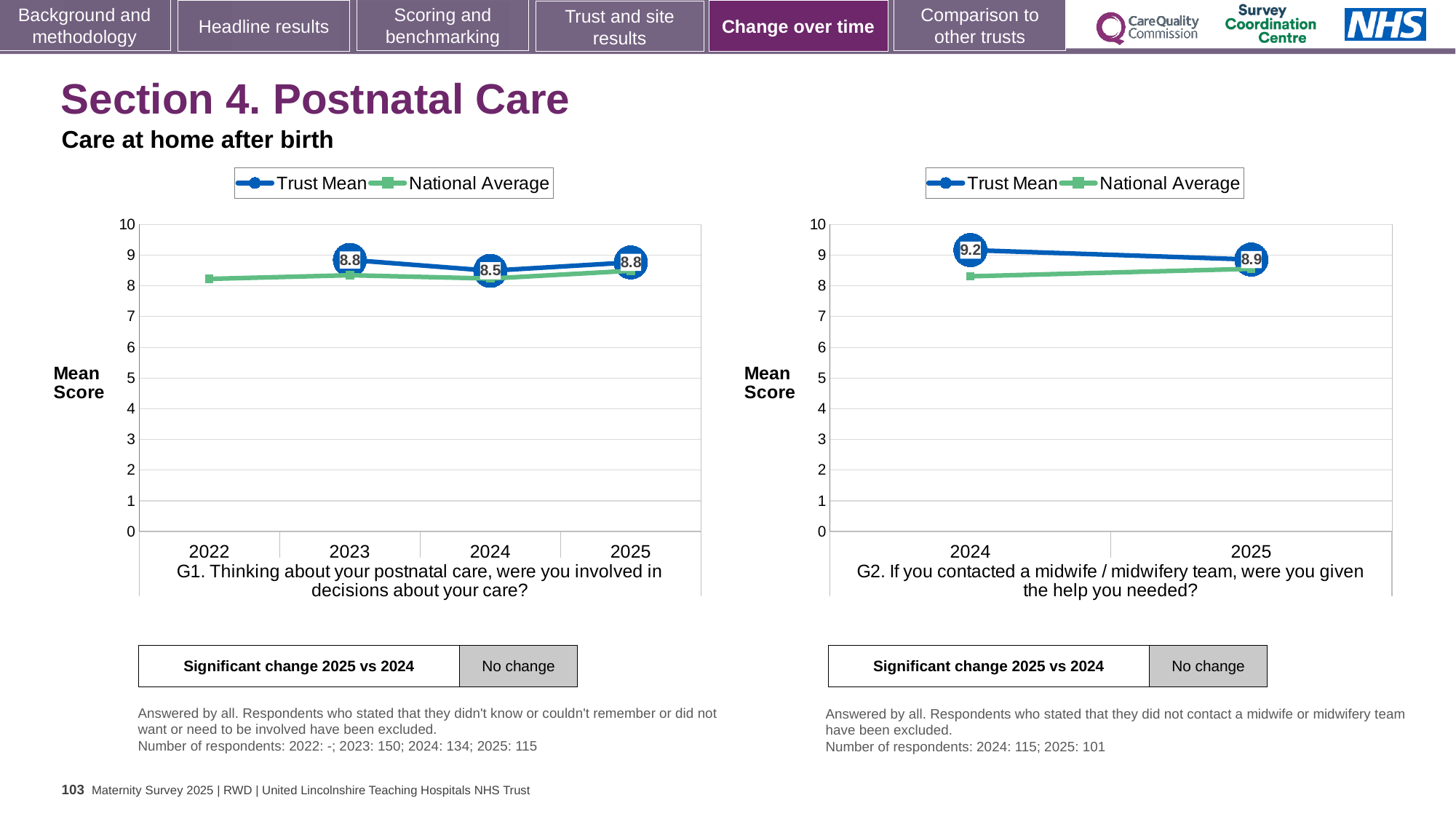
In the G2 chart on the right, what is the Trust Mean score for 2024? 9.2 In the G1 chart on the left, is the National Average for 2022 greater or less than 9? less In the G1 chart on the left, what is the difference between the Trust Mean scores for 2023 and 2024? 0.3 How many series does the legend of the G2 chart on the right list? 2 How many years are shown on the x axis of the G1 chart on the left? 4 In the G2 chart on the right, what is the Trust Mean score for 2025? 8.9 In the G2 chart on the right, is the Trust Mean for 2024 greater or less than 9? greater What kind of chart is the G2 chart on the right? Line chart In the G1 chart on the left, what is the Trust Mean score for 2025? 8.8 In the G1 chart on the left, which year has the lowest Trust Mean score? 2024 In the G2 chart on the right, what is the difference between the Trust Mean scores for 2024 and 2025? 0.3 In the G1 chart on the left, what is the Trust Mean score for 2024? 8.5